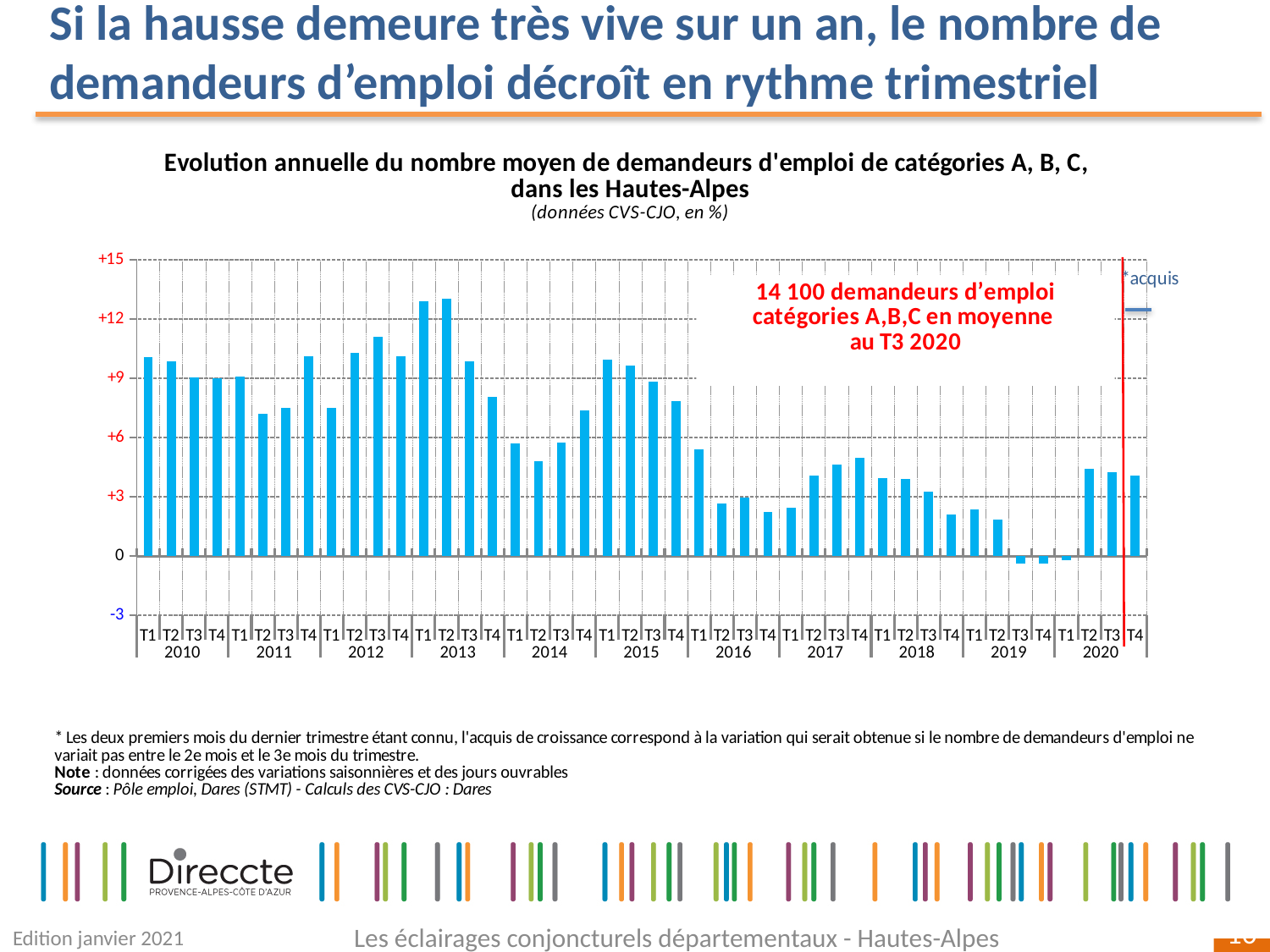
What kind of chart is shown on the slide? bar chart Do the values rise or fall from T2 2013 to T2 2014? fall How many quarterly bars are plotted in the chart (from T1 2010 to T4 2020)? 44 Is the value for T1 2010 greater or less than +9? greater Is the value for T2 2020 greater or less than +3? greater In which year does the chart reach its highest bar? 2013 Which is larger, the value for T1 2013 or the value for T1 2016? T1 2013 According to the annotation on the chart, what was the average number of category A, B, C job seekers in T3 2020? 14 100 Is the value for T3 2019 greater or less than 0? less